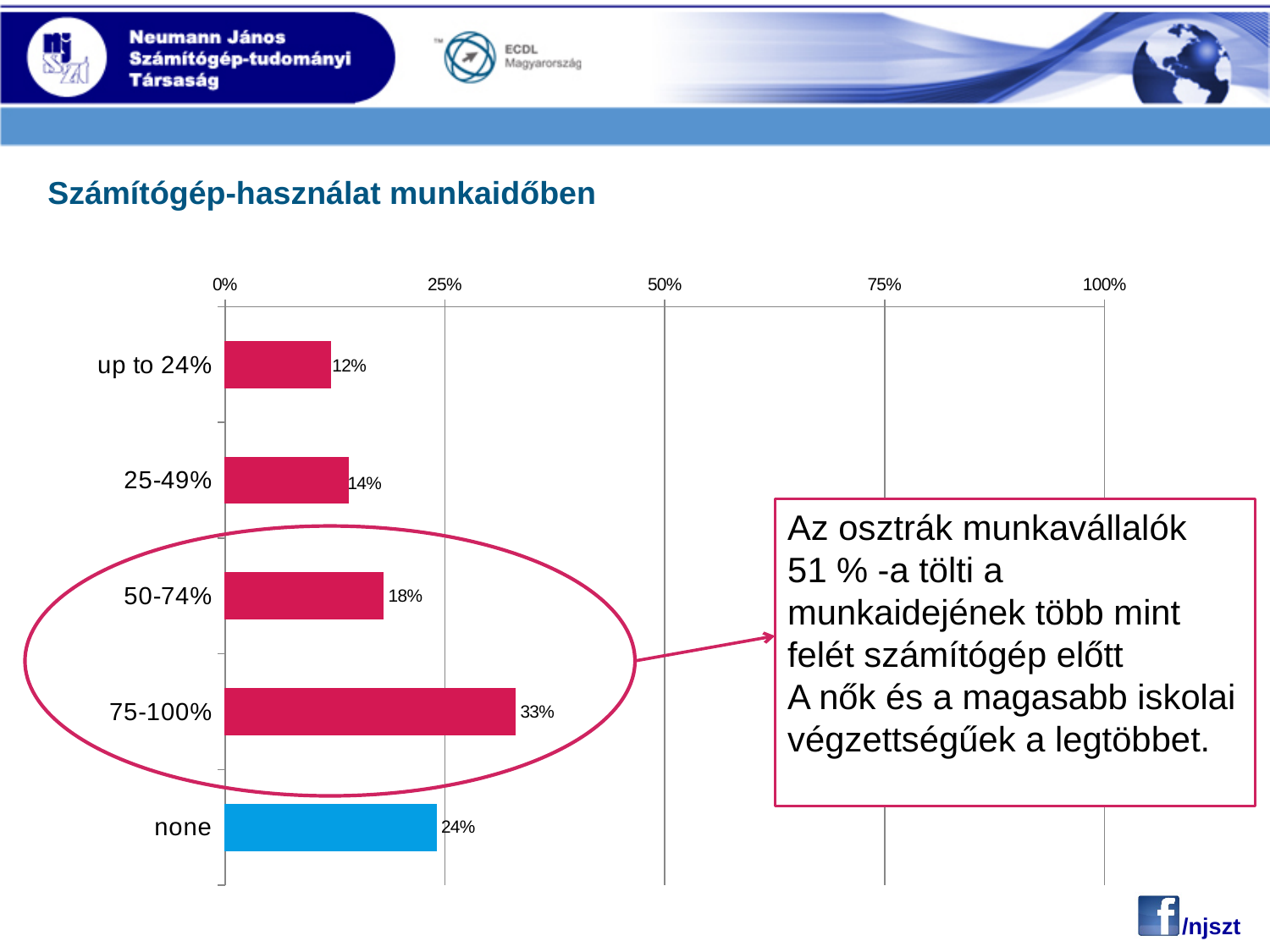
What kind of chart is shown on the slide? Bar chart What is the value for the "50-74%" category? 18% What is the value for the "75-100%" category? 33% Which category has the lowest value? up to 24% How many categories are shown in the chart? 5 What is the difference between the values for "75-100%" and "none"? 9% Is the value for "75-100%" greater or less than 25%? greater Which is larger, the value for "25-49%" or the value for "50-74%"? 50-74% What is the value for the "none" category? 24% Which category has the highest value? 75-100% What is the value for the "up to 24%" category? 12% Which category's bar is coloured blue rather than red? none